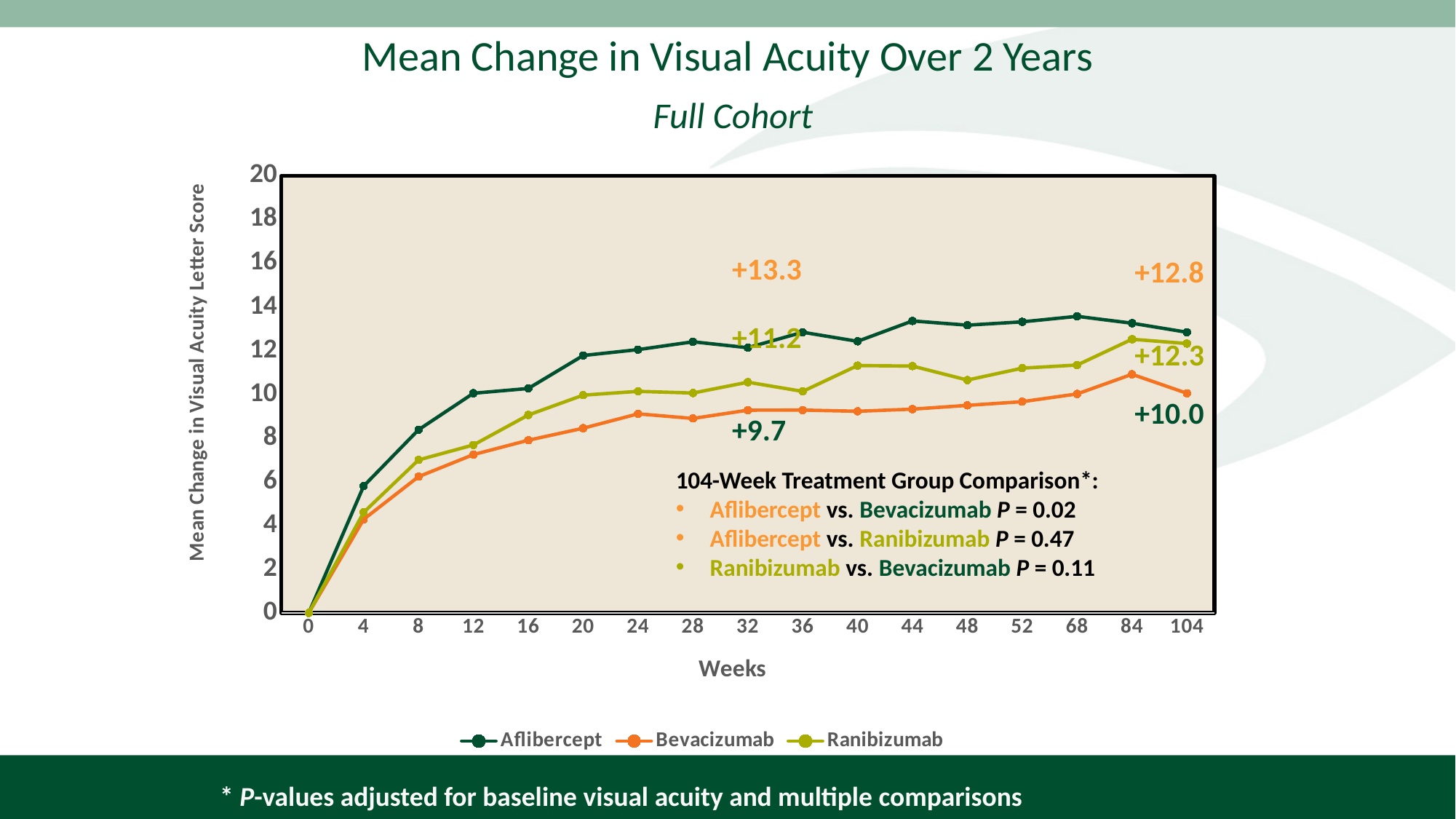
What is the labelled mean change in visual acuity letter score for Bevacizumab at week 104? +10.0 What is the labelled mean change in visual acuity letter score for Aflibercept at week 104? +12.8 Is the value for Bevacizumab at week 4 greater or less than 6? less How many series does the legend list? 3 What type of chart is shown on the slide? Line chart How many week time points are shown on the x axis? 17 At week 24, which is larger: the value for Aflibercept or the value for Bevacizumab? Aflibercept Which treatment group has the highest mean change in visual acuity at week 104? Aflibercept What is the labelled mean change in visual acuity letter score for Ranibizumab at week 104? +12.3 What is the difference between the labelled week-104 values for Aflibercept and Bevacizumab? 2.8 Which treatment group has the lowest mean change in visual acuity at week 104? Bevacizumab What is the title of the y axis? Mean Change in Visual Acuity Letter Score